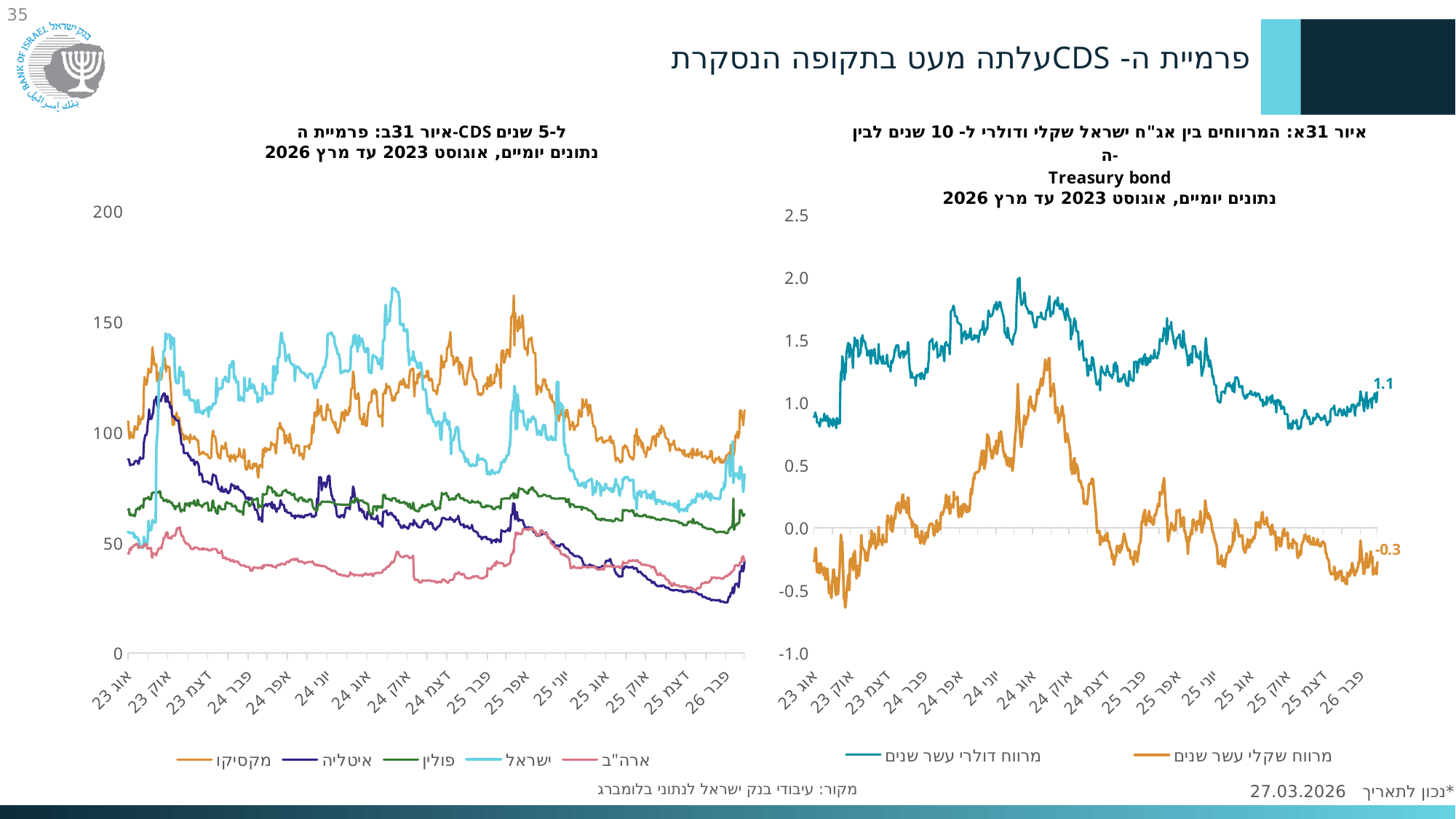
In the right chart (איור 31א), what is the final labelled value of the dollar ten-year spread (מרווח דולרי עשר שנים)? 1.1 In the right chart (איור 31א), which series has the higher final labelled value, the dollar spread or the shekel spread? מרווח דולרי עשר שנים In the right chart (איור 31א), what is the difference between the final labelled values of the dollar spread (1.1) and the shekel spread (-0.3)? 1.4 In the left chart (איור 31ב), what is the highest value shown on the y axis? 200 In the left chart (איור 31ב), how many series does the legend list? 5 What kind of chart is the left chart (איור 31ב, CDS premium for 5 years)? line chart In the right chart (איור 31א), how many series does the legend list? 2 In the right chart (איור 31א), what is the final labelled value of the shekel ten-year spread (מרווח שקלי עשר שנים)? -0.3 In the left chart (איור 31ב), is the peak value of the Israel (ישראל) line greater or less than 150? greater In the left chart (איור 31ב), which series is the lowest for most of the period? ארה"ב What kind of chart is the right chart (איור 31א, spreads between Israel bonds and Treasury bond)? line chart In the left chart (איור 31ב), is the value of the US (ארה"ב) line at the end of the period greater or less than 100? less